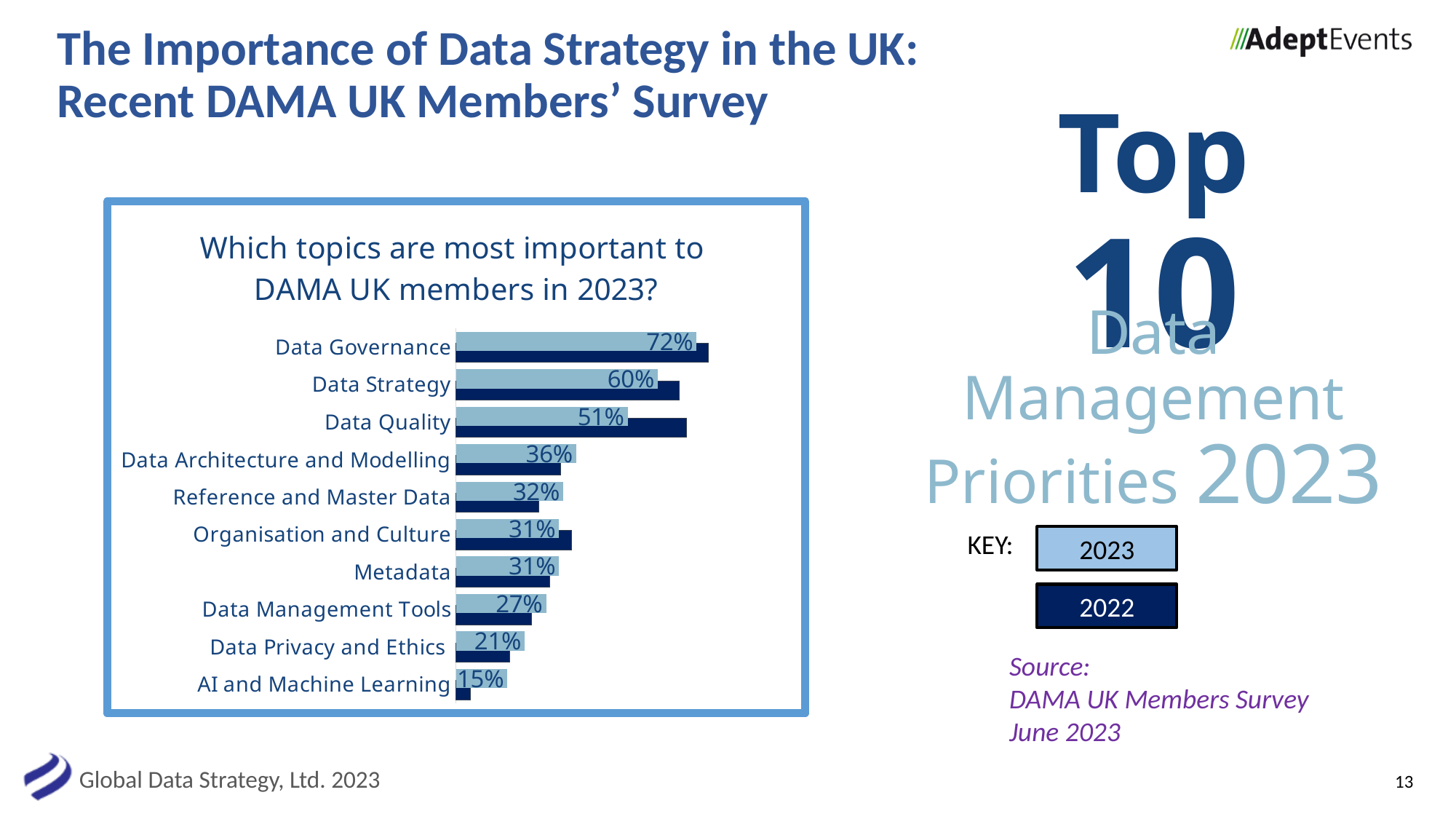
Which topic has the lowest 2023 value? AI and Machine Learning What is the 2023 value for Data Privacy and Ethics? 21% For Data Quality, is the 2022 bar or the 2023 bar longer? 2022 What percentage of DAMA UK members rated Data Governance as most important in 2023? 72% What is the 2023 value for Data Strategy? 60% How many series (years) does the key show? 2 What type of chart is shown on the slide? Bar chart Which topic has the highest 2023 value? Data Governance For AI and Machine Learning, is the 2022 bar or the 2023 bar longer? 2023 What is the 2023 value for Reference and Master Data? 32% What is the difference between the 2023 values for Data Governance and Data Strategy? 12% How many topics are listed in the chart? 10